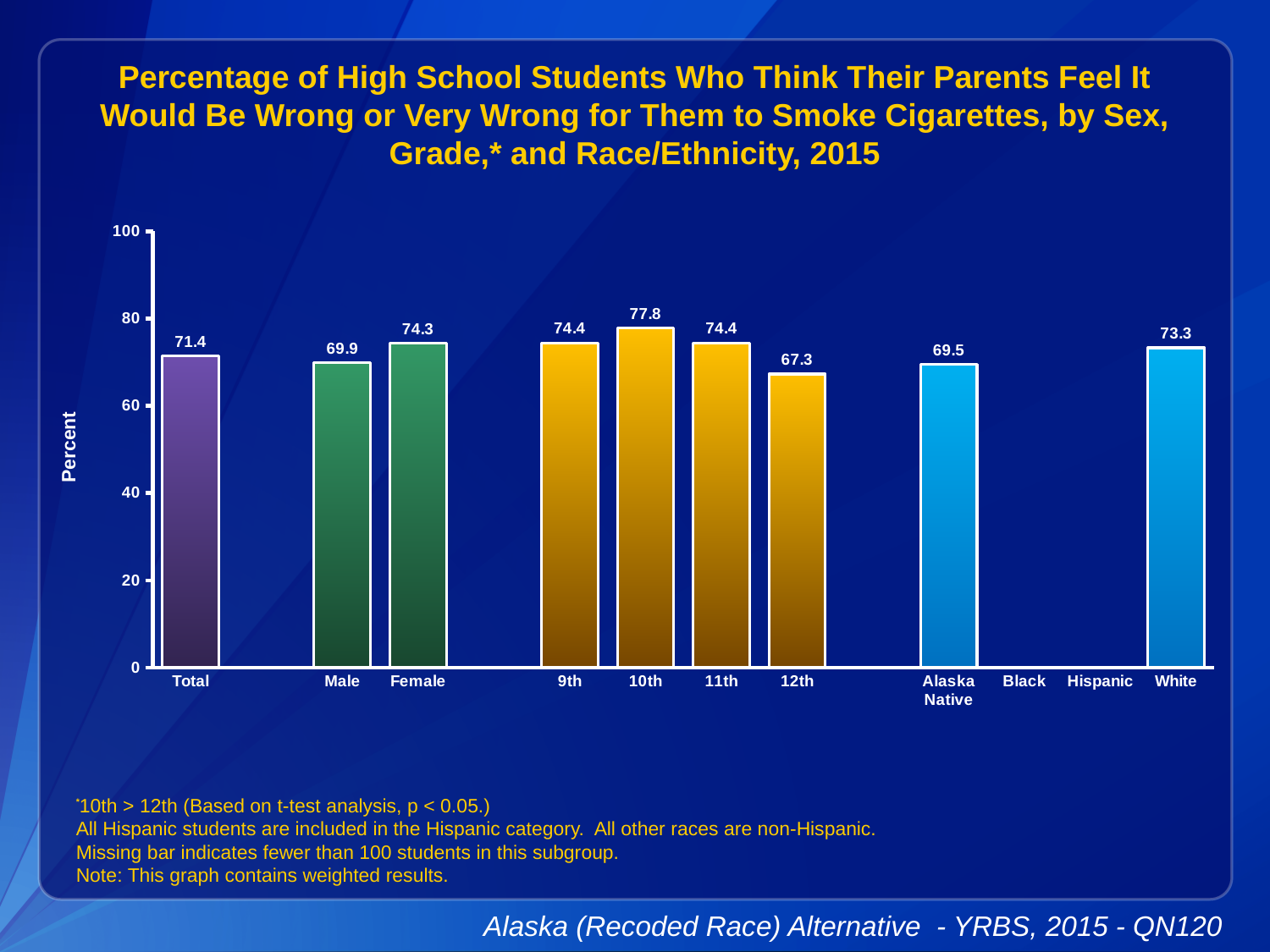
What is the value for Alaska Native? 69.5 Which is larger, the value for White or the value for Alaska Native? White Which categories on the x axis have no bar shown? Black and Hispanic What is the value for 12th grade? 67.3 What is the value for Female? 74.3 Which category has the highest value? 10th Is the value for Male greater or less than 80? less Which category with a bar has the lowest value? 12th What kind of chart is shown on the slide? bar chart What is the difference between the 10th and 12th grade values? 10.5 What is the difference between the Female and Male values? 4.4 What is the value for Total? 71.4